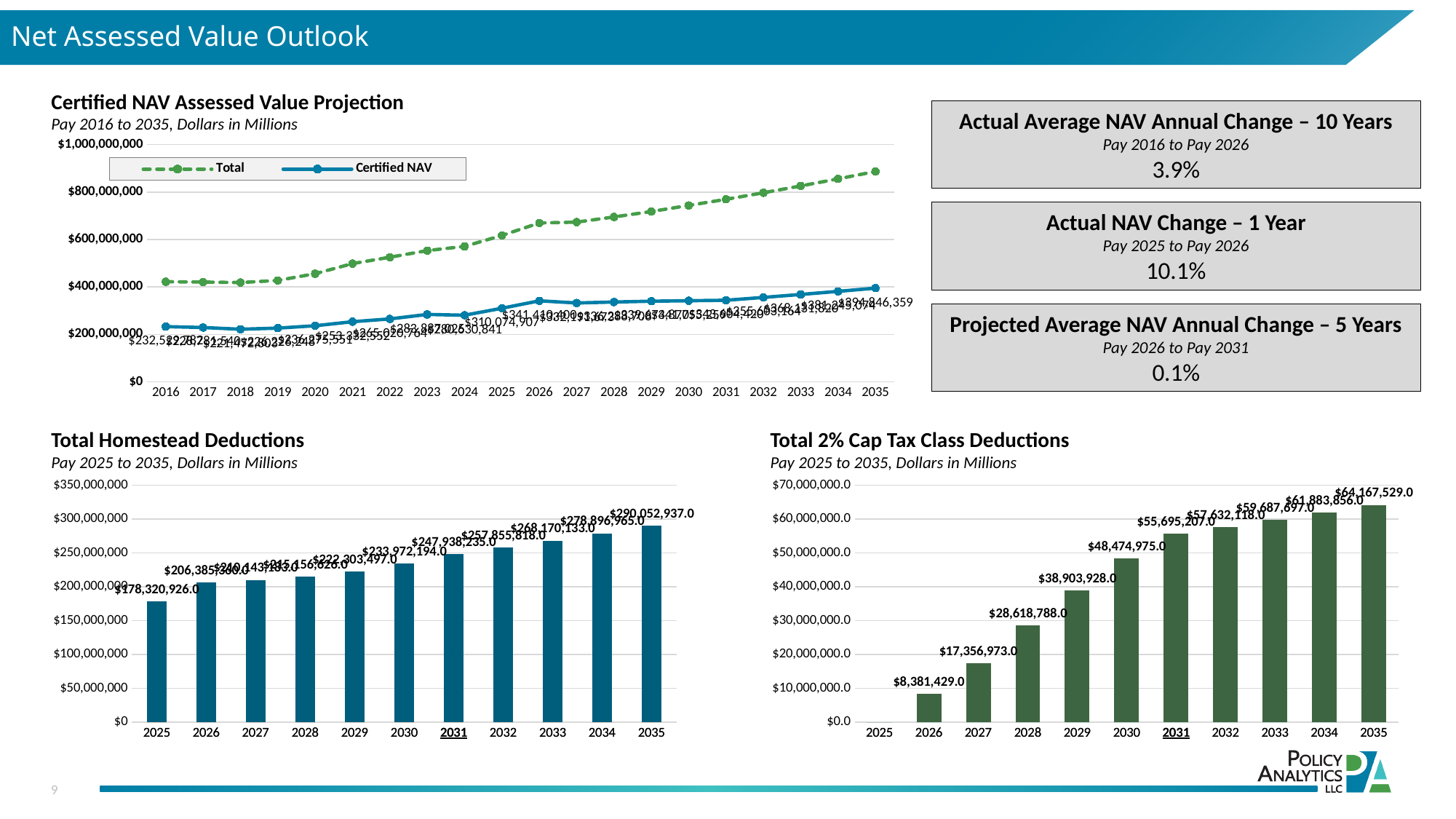
In the Certified NAV Assessed Value Projection chart, is the Total value for 2030 greater or less than $600,000,000? greater In the Total Homestead Deductions chart, which year has the highest value? 2035 In the Total 2% Cap Tax Class Deductions chart, which is larger, the value for 2028 or the value for 2029? 2029 In the Total Homestead Deductions chart, what is the difference between the 2035 and 2034 values? $11,155,972.0 In the Total Homestead Deductions chart, what is the value for 2025? $178,320,926.0 In the Total 2% Cap Tax Class Deductions chart, what is the difference between the 2035 and 2026 values? $55,786,100.0 In the Certified NAV Assessed Value Projection chart, does the Total series generally rise or fall from 2016 to 2035? rise What kind of chart is the Certified NAV Assessed Value Projection chart? line chart How many years are shown on the x axis of the Total Homestead Deductions chart? 11 How many series does the legend of the Certified NAV Assessed Value Projection chart list? 2 In the Certified NAV Assessed Value Projection chart, is the Certified NAV value for 2016 greater or less than $400,000,000? less In the Total 2% Cap Tax Class Deductions chart, what is the value for 2030? $48,474,975.0